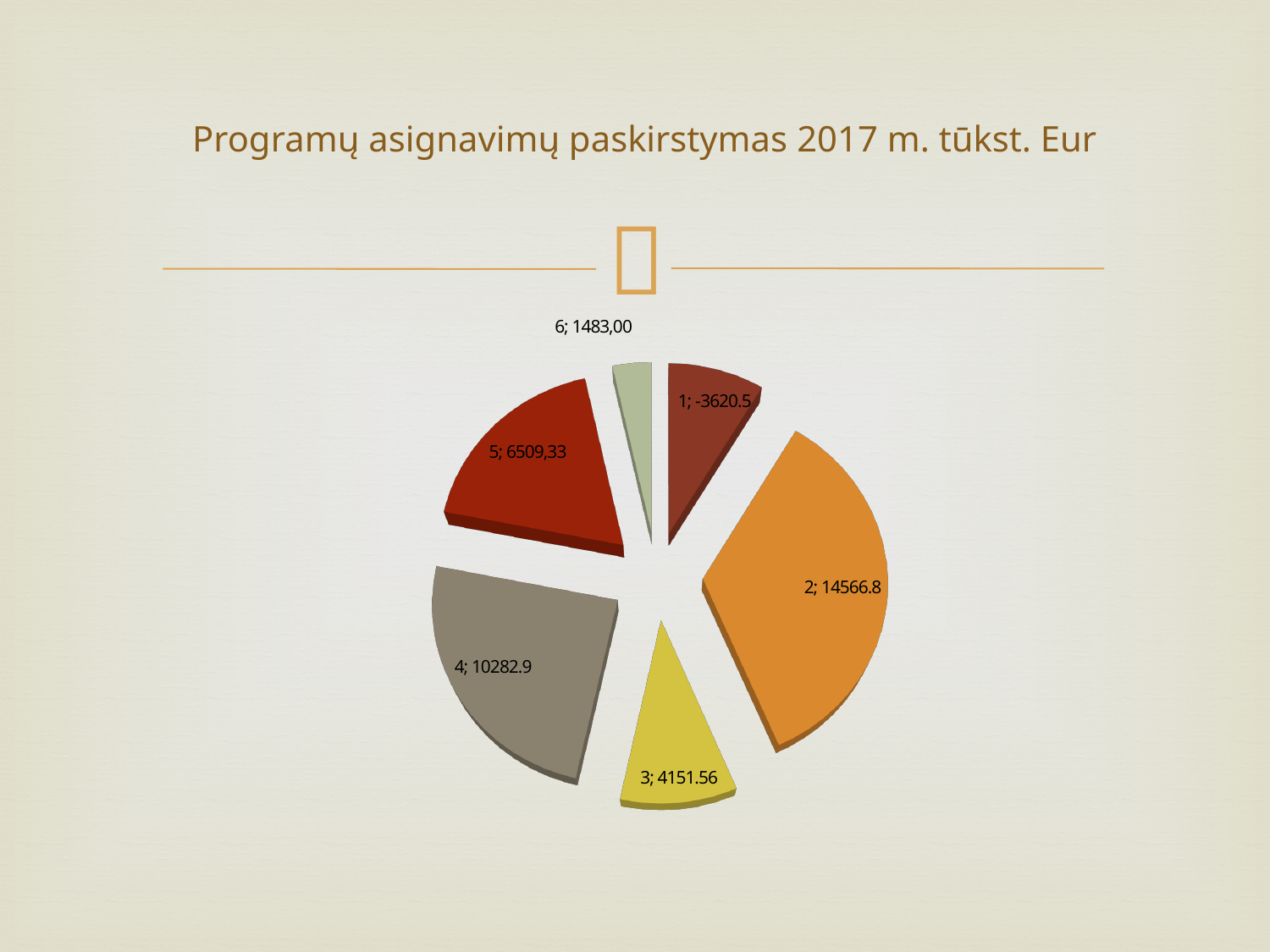
Which slice has the largest value? 2 What kind of chart is shown on the slide? pie chart What is the difference between the values of slice 2 and slice 4? 4283.9 Which slice is the smallest in the pie? 6 What is the value shown for slice 3? 4151.56 What is the title of the chart? Programų asignavimų paskirstymas 2017 m. tūkst. Eur What is the value shown for slice 5? 6509,33 Which is larger, the value for slice 4 or the value for slice 3? slice 4 How many slices does the pie chart have? 6 What is the value shown for slice 6? 1483,00 What is the value shown for slice 4? 10282.9 What is the value shown for slice 2? 14566.8